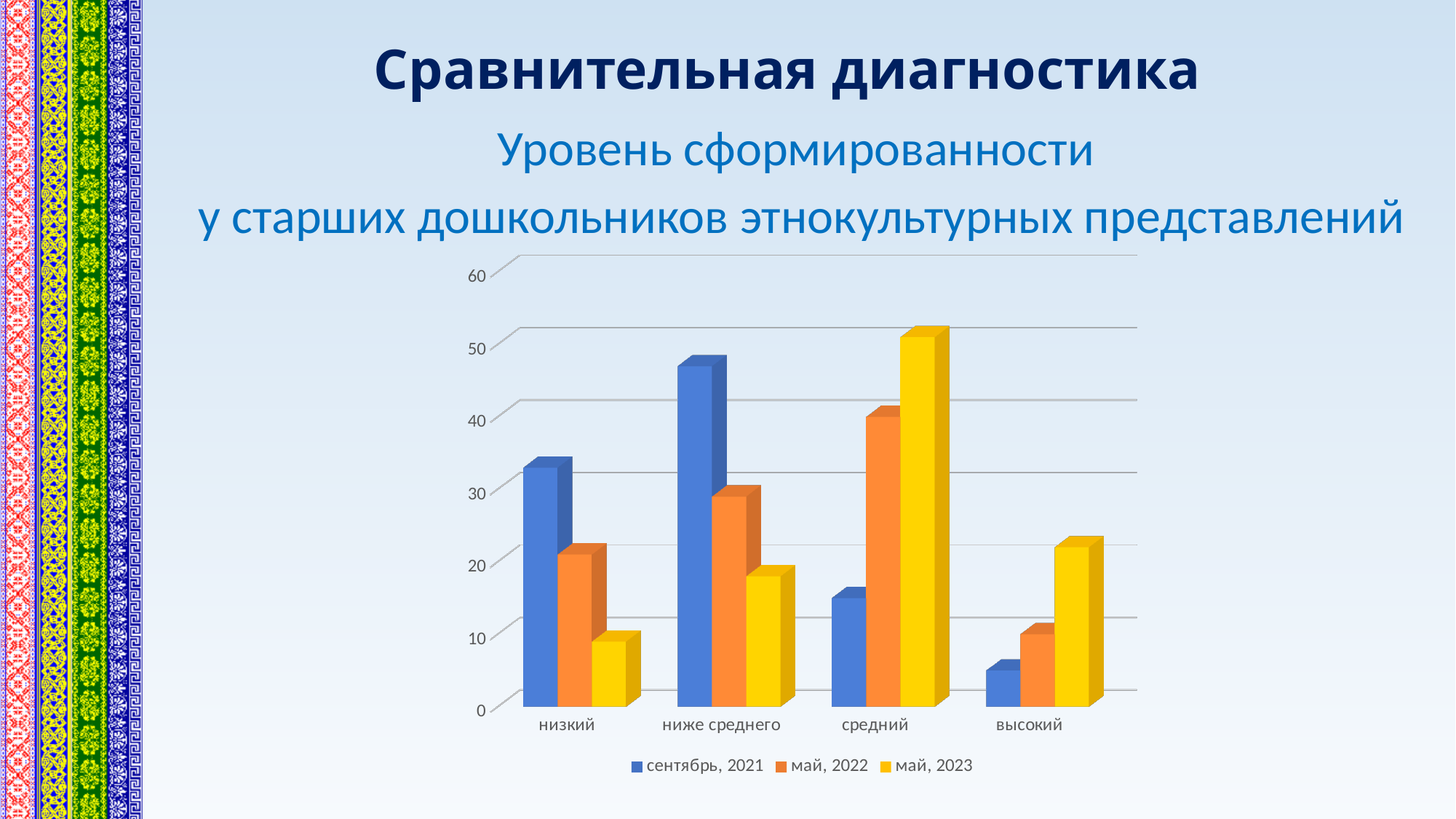
Is the value for май, 2023 in the средний category greater or less than 40? greater In the низкий category, do the values rise or fall from сентябрь, 2021 to май, 2023? fall Is the value for сентябрь, 2021 in the высокий category greater or less than 10? less Is the value for сентябрь, 2021 in the ниже среднего category greater or less than 40? greater Which category has the highest value for the сентябрь, 2021 series? ниже среднего Which category has the highest value for the май, 2023 series? средний How many series does the chart legend list? 3 Which colour represents the май, 2022 series in the chart? orange How many categories are shown on the x axis of the chart? 4 In the средний category, which series has the larger value: сентябрь, 2021 or май, 2023? май, 2023 Which category has the lowest value for the сентябрь, 2021 series? высокий What kind of chart is shown on the slide? bar chart